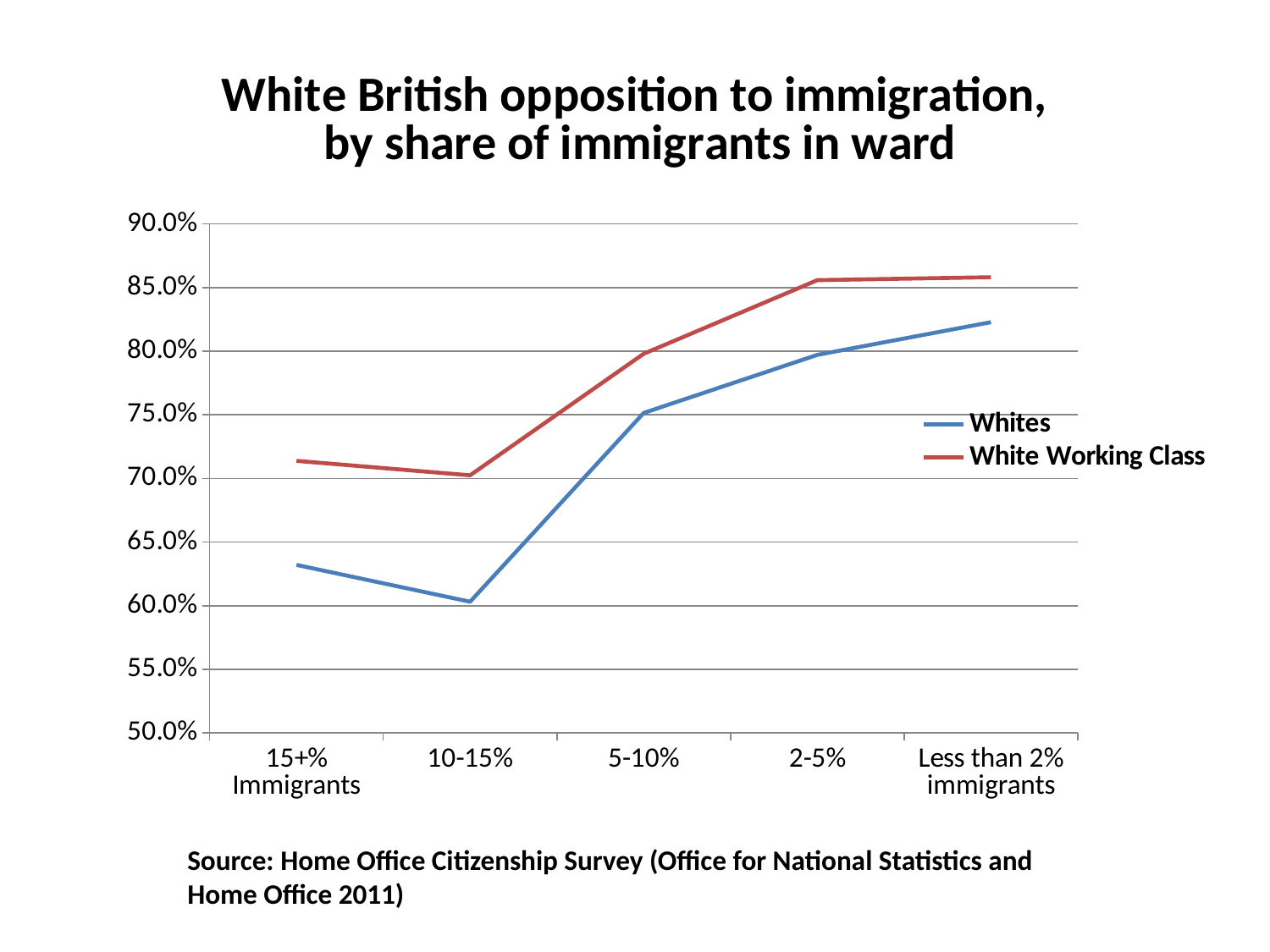
For which ward category is the Whites series lowest? 10-15% In 2-5% wards, which series has the higher value, Whites or White Working Class? White Working Class Is the value for Whites in 5-10% wards greater or less than 70.0%? greater Is the value for Whites in Less than 2% immigrants wards greater or less than 80.0%? greater What kind of chart is shown on the slide? line chart For which ward category is the Whites series highest? Less than 2% immigrants Is the value for Whites in 10-15% wards greater or less than 65.0%? less How many series does the legend list? 2 How many ward categories are shown along the x axis? 5 Which colour is used for the White Working Class line? red Moving from 10-15% wards to Less than 2% immigrants wards, do the values for Whites rise or fall? rise